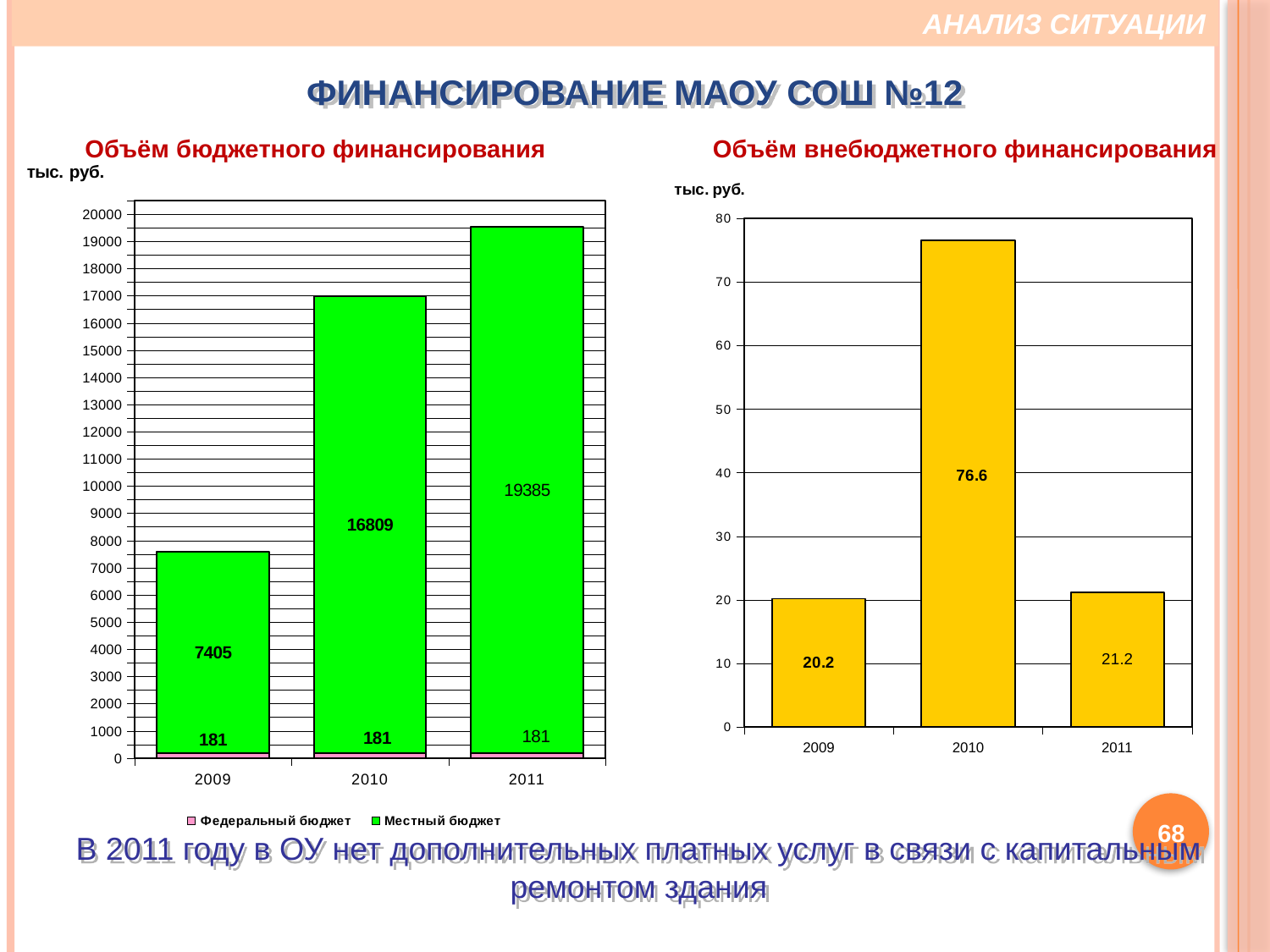
How many years are shown on the x axis of the chart 'Объём внебюджетного финансирования'? 3 In the chart 'Объём внебюджетного финансирования', what is the difference between the values for 2010 and 2009? 56.4 In the chart 'Объём внебюджетного финансирования', what is the value for 2010? 76.6 In the chart 'Объём бюджетного финансирования', which year has the highest Местный бюджет value? 2011 In the chart 'Объём бюджетного финансирования', what is the value of Местный бюджет for 2010? 16809 In the chart 'Объём бюджетного финансирования', what is the total of the stacked bar for 2011? 19566 In the chart 'Объём бюджетного финансирования', what is the difference between the Местный бюджет values for 2011 and 2010? 2576 In the chart 'Объём бюджетного финансирования', what is the value of Федеральный бюджет for 2009? 181 In the chart 'Объём внебюджетного финансирования', is the value for 2011 greater or less than 30? less In the chart 'Объём внебюджетного финансирования', which year has the lowest value? 2009 What kind of chart is 'Объём внебюджетного финансирования'? bar chart How many series does the legend of the chart 'Объём бюджетного финансирования' list? 2